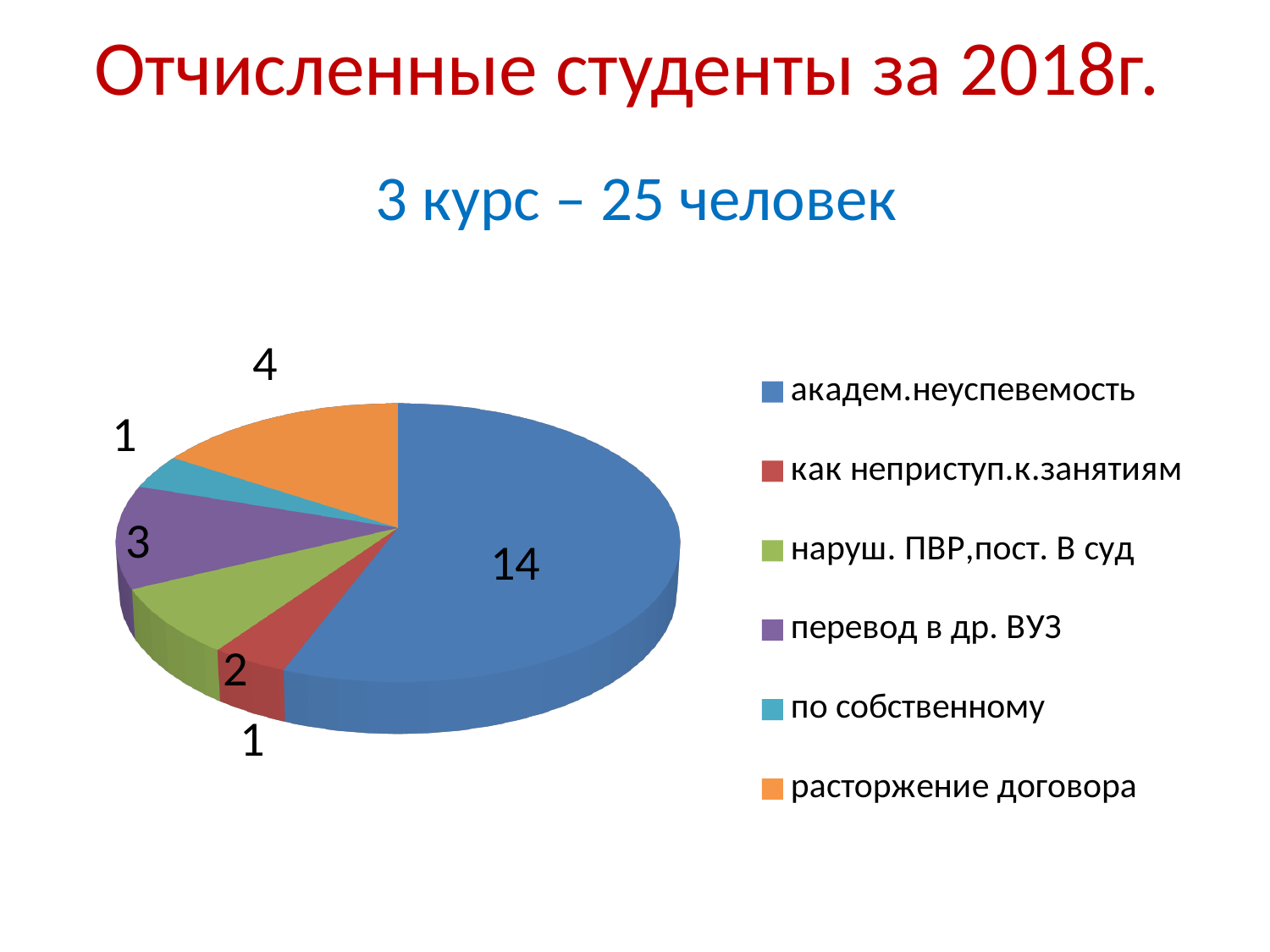
Which category has the largest slice of the pie? академ.неуспевемость How many slices does the pie chart have? 6 What share of the pie does академ.неуспевемость represent? 56% Which is larger, the value for перевод в др. ВУЗ or the value for наруш. ПВР,пост. В суд? перевод в др. ВУЗ What colour is the slice for расторжение договора? orange What is the value for академ.неуспевемость? 14 What is the value for расторжение договора? 4 What kind of chart is shown on the slide? pie chart What is the value for наруш. ПВР,пост. В суд? 2 What is the difference between the values for академ.неуспевемость and расторжение договора? 10 What is the value for перевод в др. ВУЗ? 3 What is the total of all the slices in the pie chart? 25